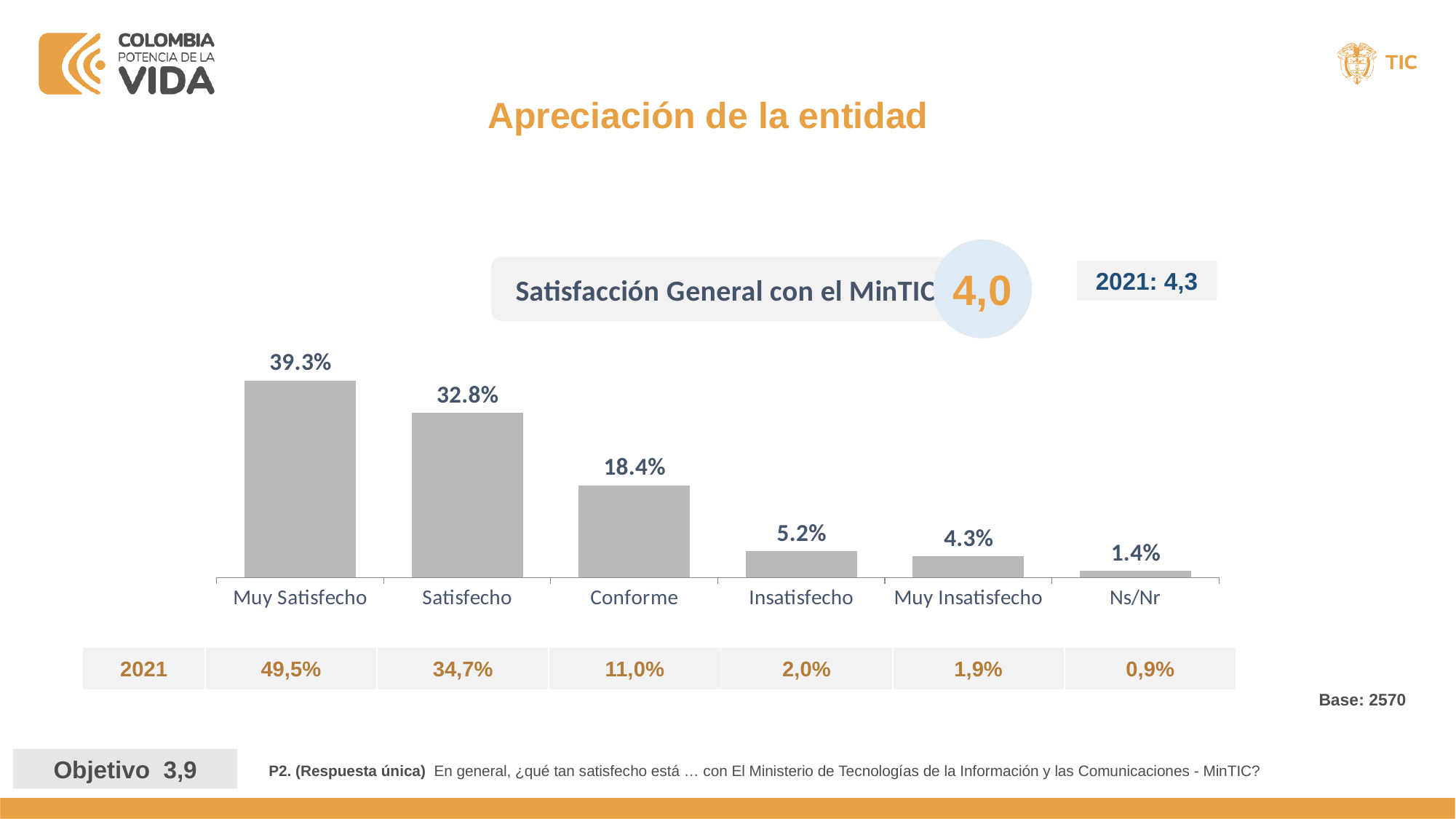
What is the value for Muy Satisfecho? 39.3% Which is larger, the value for Insatisfecho or the value for Muy Insatisfecho? Insatisfecho What is the value for Conforme? 18.4% Which category has the highest value? Muy Satisfecho What is the value for Ns/Nr? 1.4% How many categories are shown on the x axis? 6 What is the Satisfacción General con el MinTIC score shown on the slide? 4,0 What is the difference between the values for Muy Satisfecho and Satisfecho? 6.5% Do the values rise or fall from left to right along the x axis? Fall Which category has the lowest value? Ns/Nr What kind of chart is shown on the slide? Bar chart What is the 2021 value shown in the table for Muy Satisfecho? 49,5%